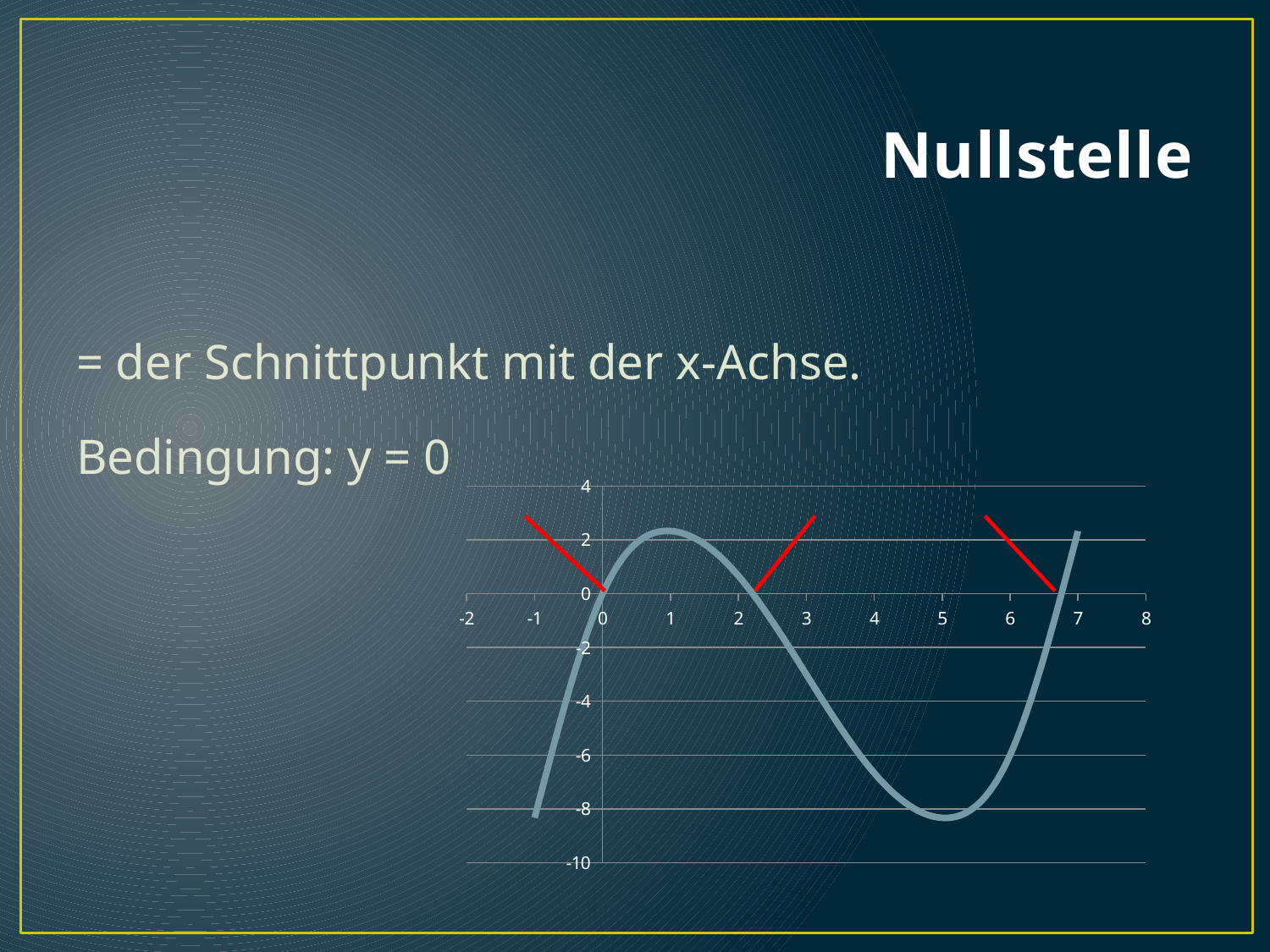
What is the lowest value shown on the y-axis of the chart? -10 What is the highest value shown on the x-axis of the chart? 8 Is the value of the curve at x = 5 greater or less than -4? less Between x = 1 and x = 5, do the values of the curve rise or fall? fall Is the value of the curve at x = 1 greater or less than 0? greater Between x = 5 and x = 7, do the values of the curve rise or fall? rise Is the value of the curve at x = 7 greater or less than 0? greater How many red marks indicating zero crossings (Nullstellen) are drawn on the chart? 3 What kind of chart is shown on the slide? line chart How many times does the plotted curve cross the x-axis? 3